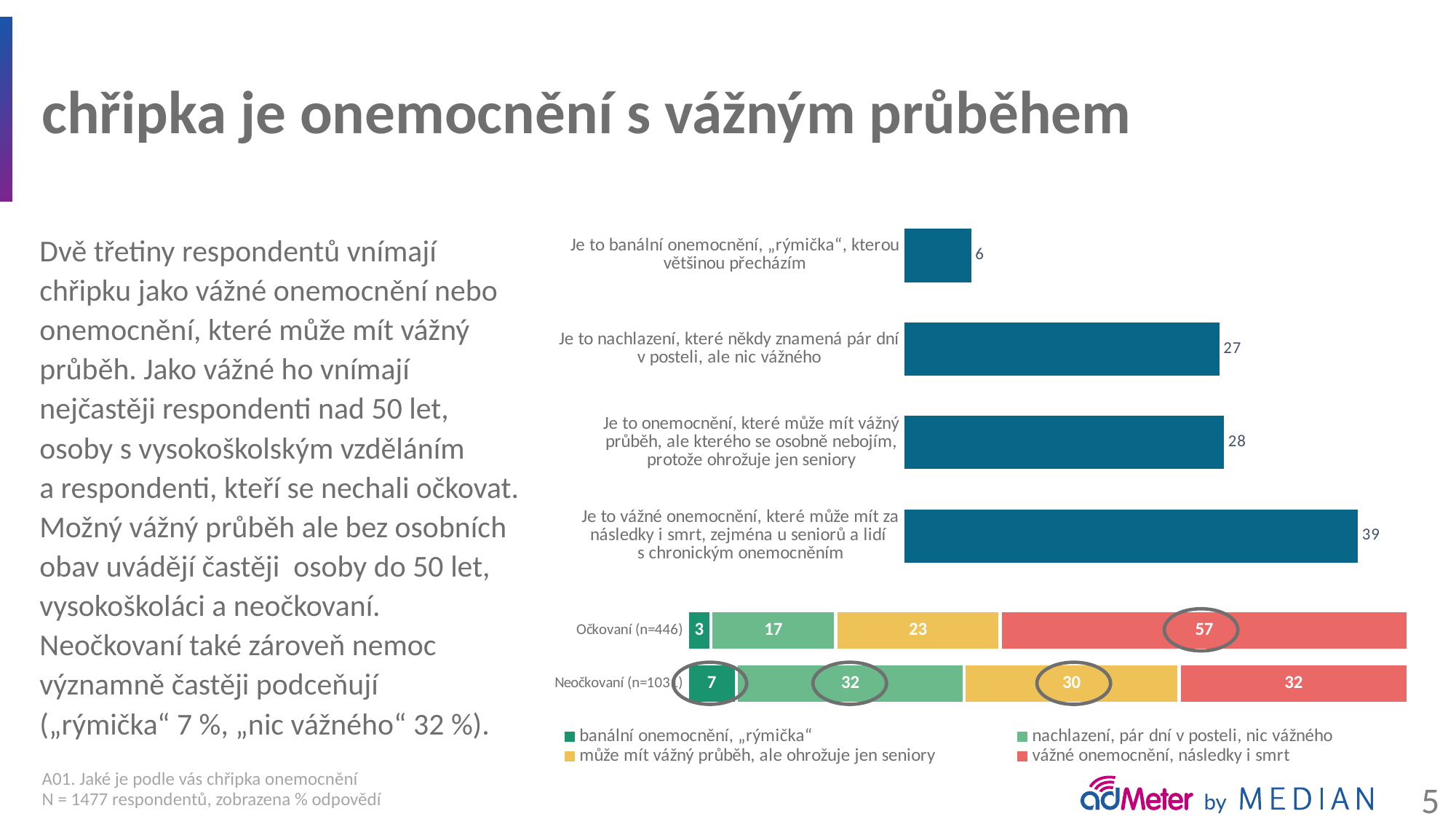
What type of chart is the top chart on the slide? Bar chart How many categories (statements) are shown in the top bar chart? 4 In the top bar chart, which statement has the lowest value? Je to banální onemocnění, „rýmička“, kterou většinou přecházím In the top bar chart, what value is shown for the statement that flu is a serious illness that can have consequences including death ("Je to vážné onemocnění, které může mít za následky i smrt...")? 39 In the bottom stacked bar chart, which group has the larger value for the dark green segment ("banální onemocnění, „rýmička“"): Očkovaní or Neočkovaní? Neočkovaní How many series does the legend of the bottom stacked bar chart list? 4 In the bottom stacked bar chart, what is the value of the light green segment ("nachlazení, pár dní v posteli, nic vážného") for Neočkovaní? 32 In the bottom stacked bar chart, what is the difference between the red segment values for Očkovaní (57) and Neočkovaní (32)? 25 In the bottom stacked bar chart, what is the value of the red segment ("vážné onemocnění, následky i smrt") for Očkovaní (n=446)? 57 In the top bar chart, what value is shown for "Je to banální onemocnění, „rýmička“, kterou většinou přecházím"? 6 In the top bar chart, what is the difference between the value for "Je to vážné onemocnění..." (39) and "Je to nachlazení..." (27)? 12 In the top bar chart, which statement has the highest value? Je to vážné onemocnění, které může mít za následky i smrt, zejména u seniorů a lidí s chronickým onemocněním